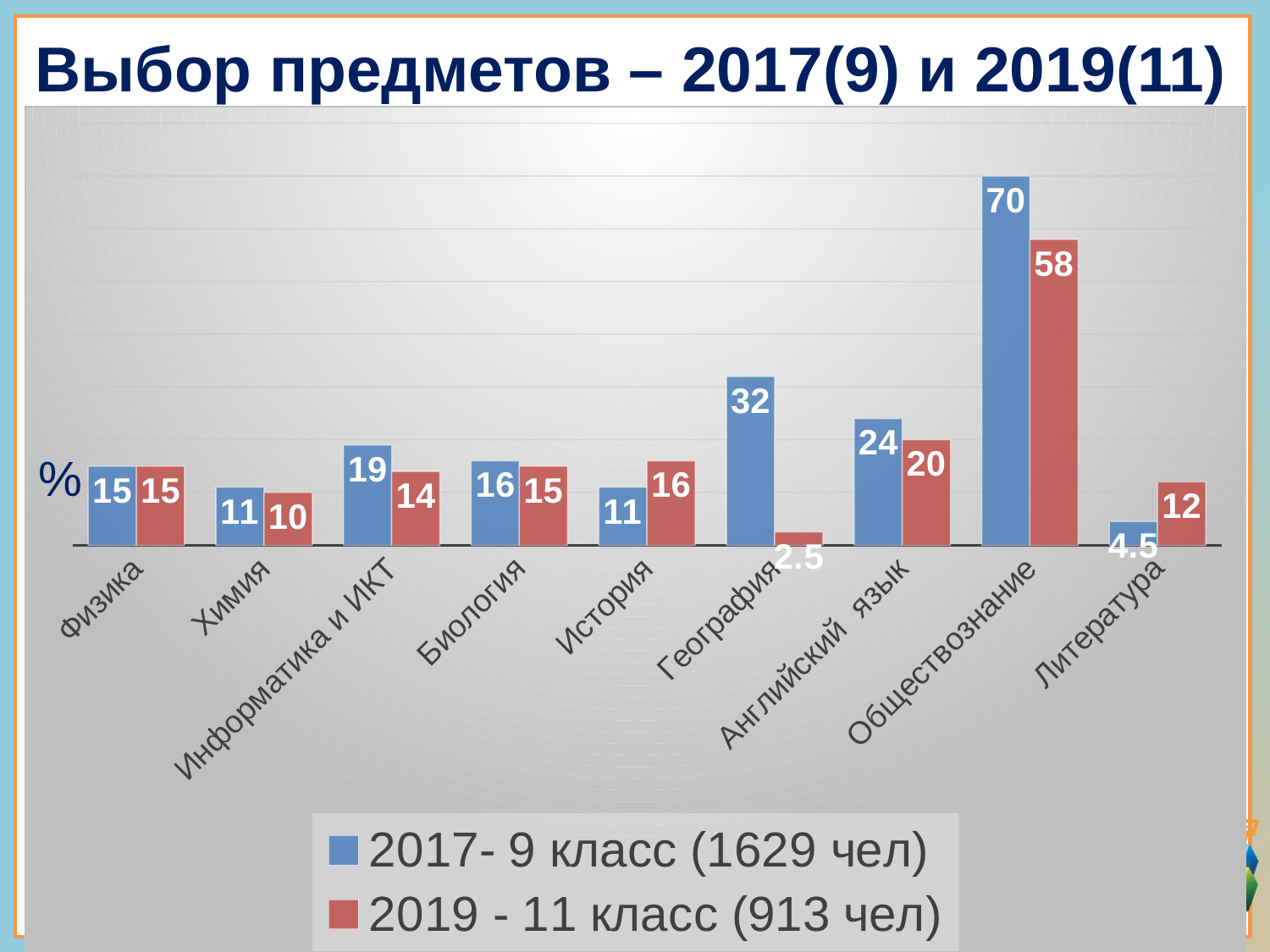
What is the value for География in the 2019 - 11 класс (913 чел) series? 2.5 What kind of chart is shown on the slide? bar chart How many subject categories are shown on the x axis? 9 What is the difference between the 2017- 9 класс and 2019 - 11 класс values for Обществознание? 12 What is the difference between the 2017- 9 класс and 2019 - 11 класс values for География? 29.5 What is the value for Литература in the 2017- 9 класс (1629 чел) series? 4.5 How many series does the legend list? 2 Which is larger for История: the 2017- 9 класс value or the 2019 - 11 класс value? 2019 - 11 класс What is the value for Обществознание in the 2017- 9 класс (1629 чел) series? 70 What is the title of the slide? Выбор предметов – 2017(9) и 2019(11) Which category has the highest value in the 2019 - 11 класс (913 чел) series? Обществознание Which category has the lowest value in the 2017- 9 класс (1629 чел) series? Литература